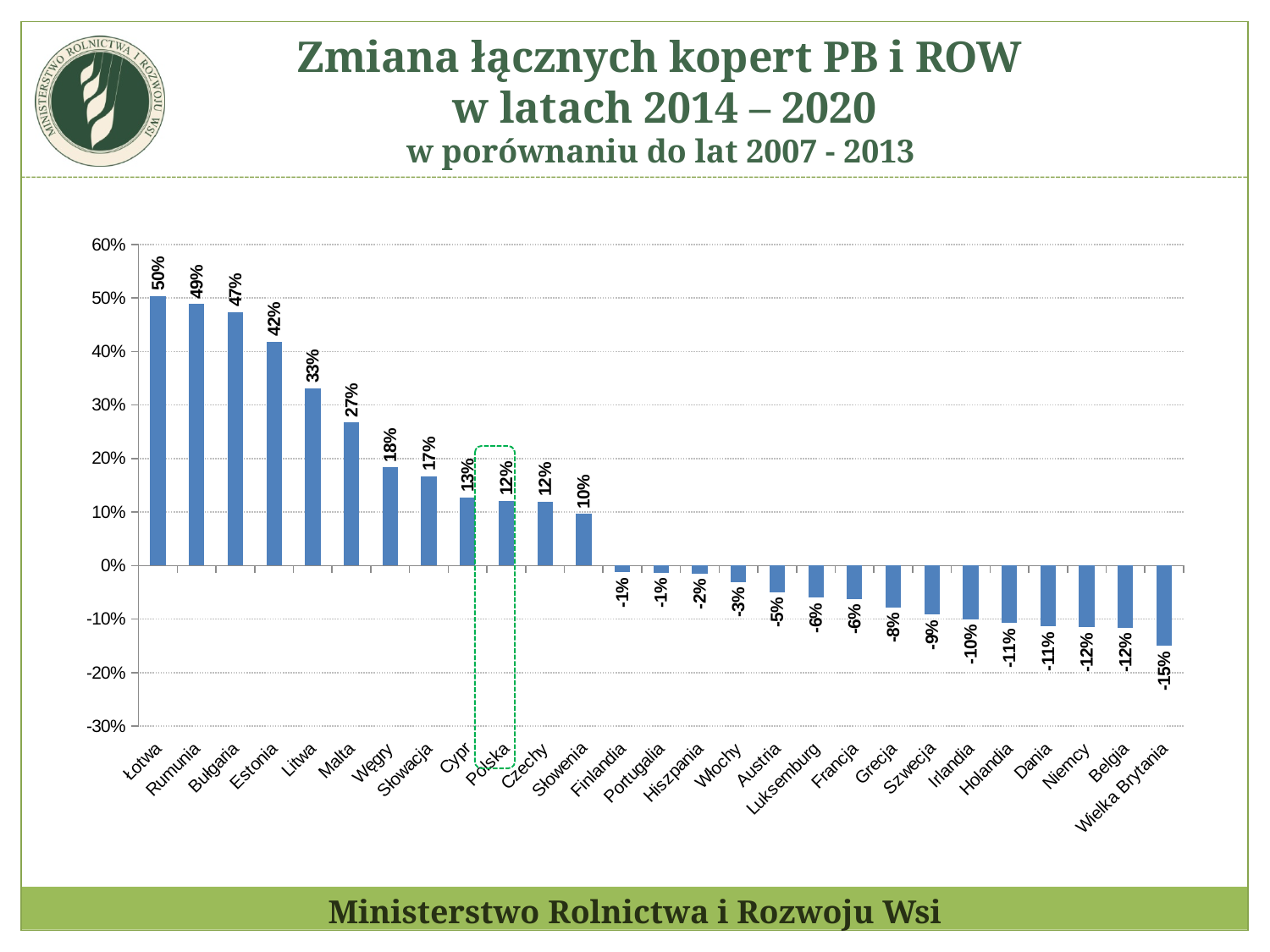
Which country has the highest value? Łotwa What kind of chart is shown on the slide? bar chart How many countries are shown on the chart? 27 Do the values rise or fall from left to right along the x axis? fall Is the value for Bułgaria greater or less than 40%? greater What is the value for Polska? 12% What is the value for Wielka Brytania? -15% Which has a larger value, Malta or Węgry? Malta What is the value for Estonia? 42% Which country's bar is highlighted with a dashed green outline? Polska What is the difference between the values for Łotwa and Litwa? 17 percentage points Which country has the lowest value? Wielka Brytania